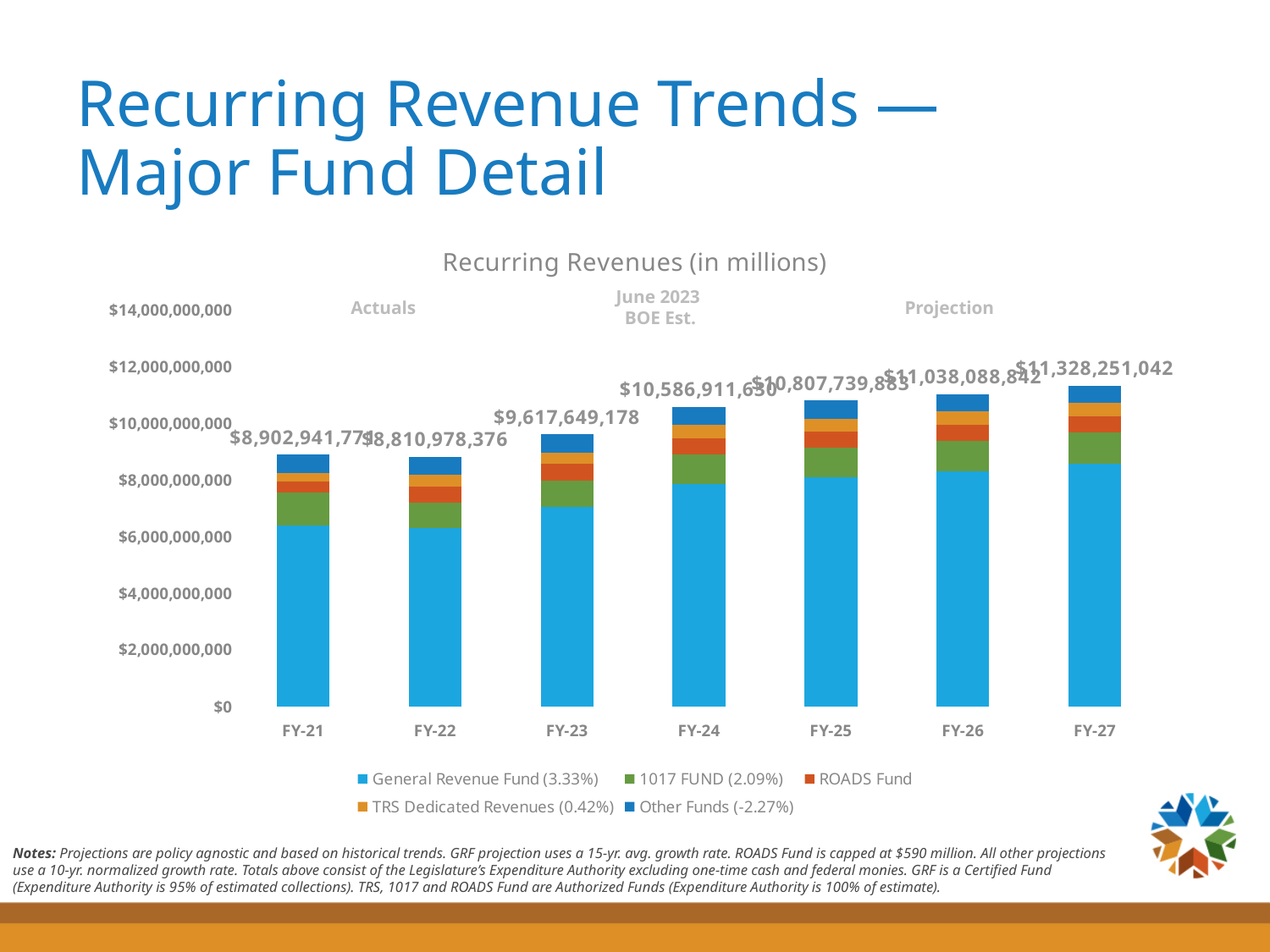
Is the General Revenue Fund value for FY-21 greater or less than $6,000,000,000? greater Which fiscal year has the highest total recurring revenue? FY-27 By how much does the FY-27 total exceed the FY-23 total? $1,710,601,864 How many series does the legend list? 5 Is the total for FY-24 greater or less than $10,000,000,000? greater What kind of chart is shown on the slide? Stacked bar chart How many fiscal years are shown on the x axis? 7 What is the difference between the FY-23 total and the FY-22 total? $806,670,802 Which is larger, the total for FY-27 or the total for FY-22? FY-27 What is the total recurring revenue shown for FY-23? $9,617,649,178 What is the total recurring revenue shown for FY-27? $11,328,251,042 What is the total recurring revenue shown for FY-22? $8,810,978,376